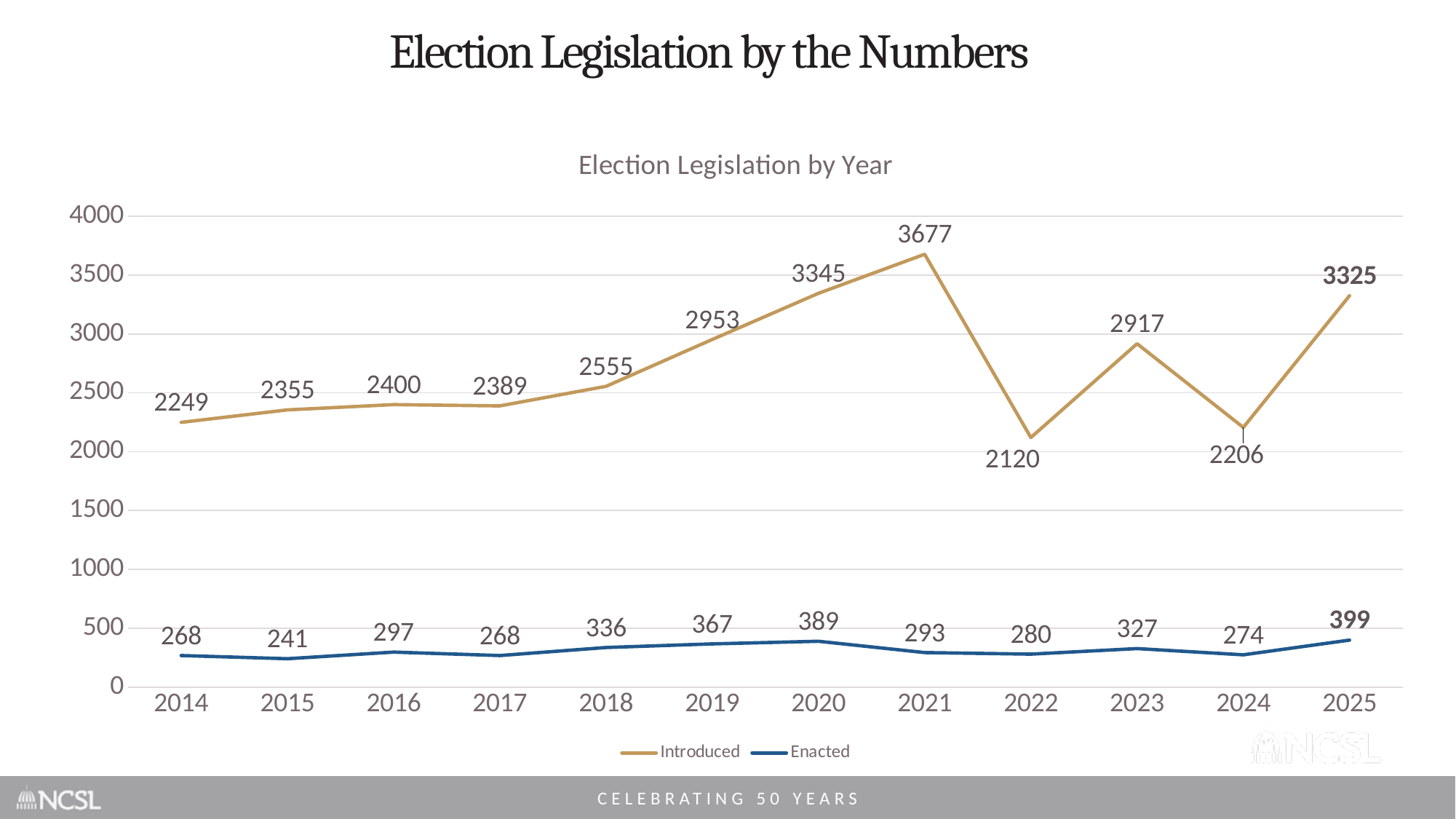
Which is larger, the Enacted value for 2020 or for 2023? 2020 Which year has the highest Introduced value? 2021 Is the Introduced value for 2019 greater or less than 3000? less How many years are shown on the x axis? 12 Which year has the lowest Enacted value? 2015 What is the value for Introduced in 2022? 2120 What is the value for Introduced in 2021? 3677 What is the value for Enacted in 2025? 399 What kind of chart is shown? line chart How many series does the legend list? 2 What is the title of the chart? Election Legislation by Year What is the difference between the Introduced values for 2021 and 2022? 1557